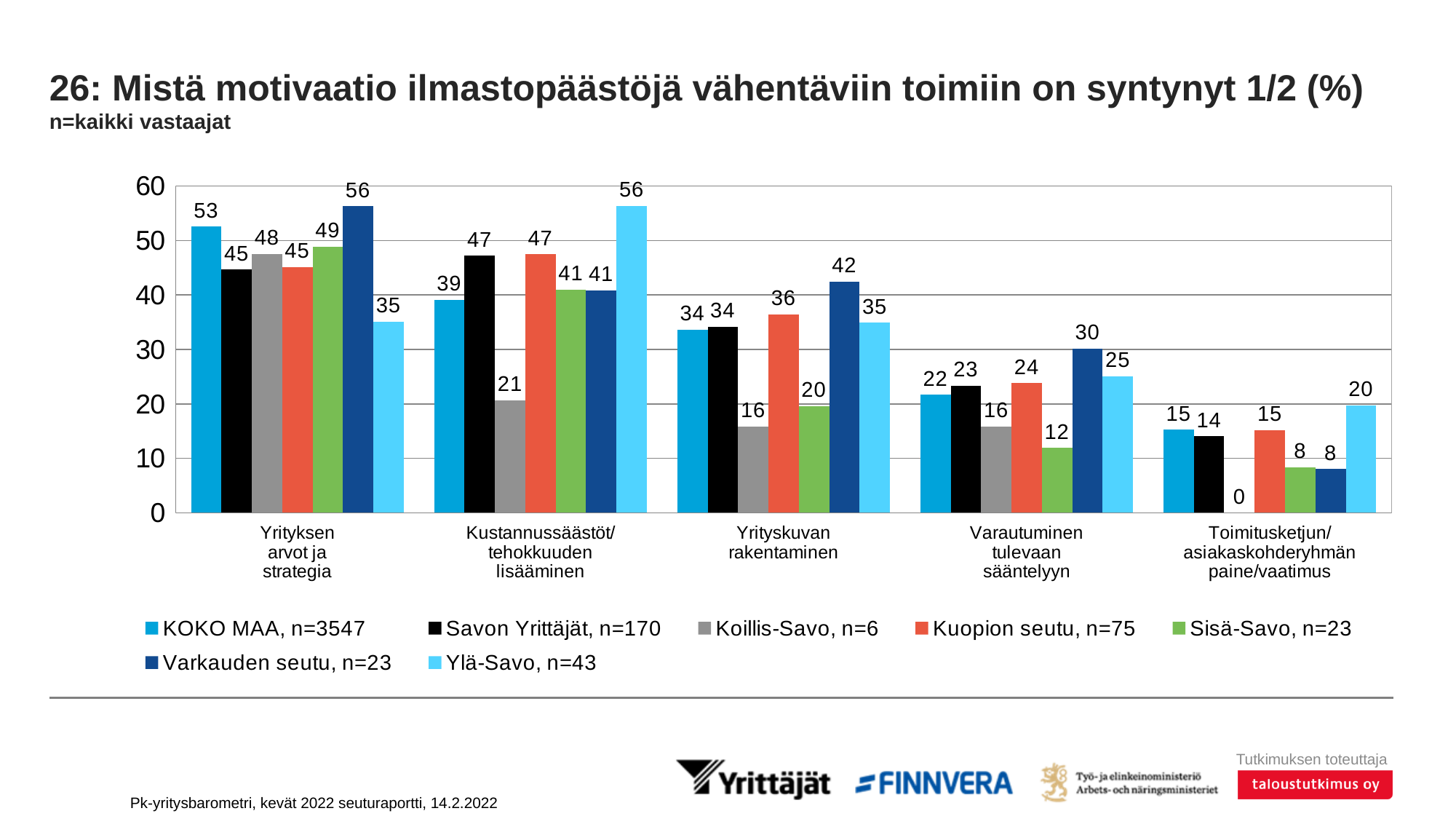
Which series has the lowest value in the category 'Varautuminen tulevaan sääntelyyn'? Sisä-Savo, n=23 What kind of chart is shown on the slide? bar chart What is the difference between the Varkauden seutu value and the Ylä-Savo value in the category 'Yrityksen arvot ja strategia'? 21 Is the value for Kuopion seutu in the category 'Yrityskuvan rakentaminen' greater or less than 30? greater What is the value for Koillis-Savo in the category 'Toimitusketjun/asiakaskohderyhmän paine/vaatimus'? 0 What is the sample size (n) given in the legend for Savon Yrittäjät? 170 What is the value for KOKO MAA in the category 'Yrityksen arvot ja strategia'? 53 How many series does the legend list? 7 What is the value for Ylä-Savo in the category 'Kustannussäästöt/tehokkuuden lisääminen'? 56 Which series has the highest value in the category 'Yrityskuvan rakentaminen'? Varkauden seutu, n=23 In the category 'Kustannussäästöt/tehokkuuden lisääminen', which is larger: the value for Savon Yrittäjät or the value for Koillis-Savo? Savon Yrittäjät How many categories are shown on the x axis? 5